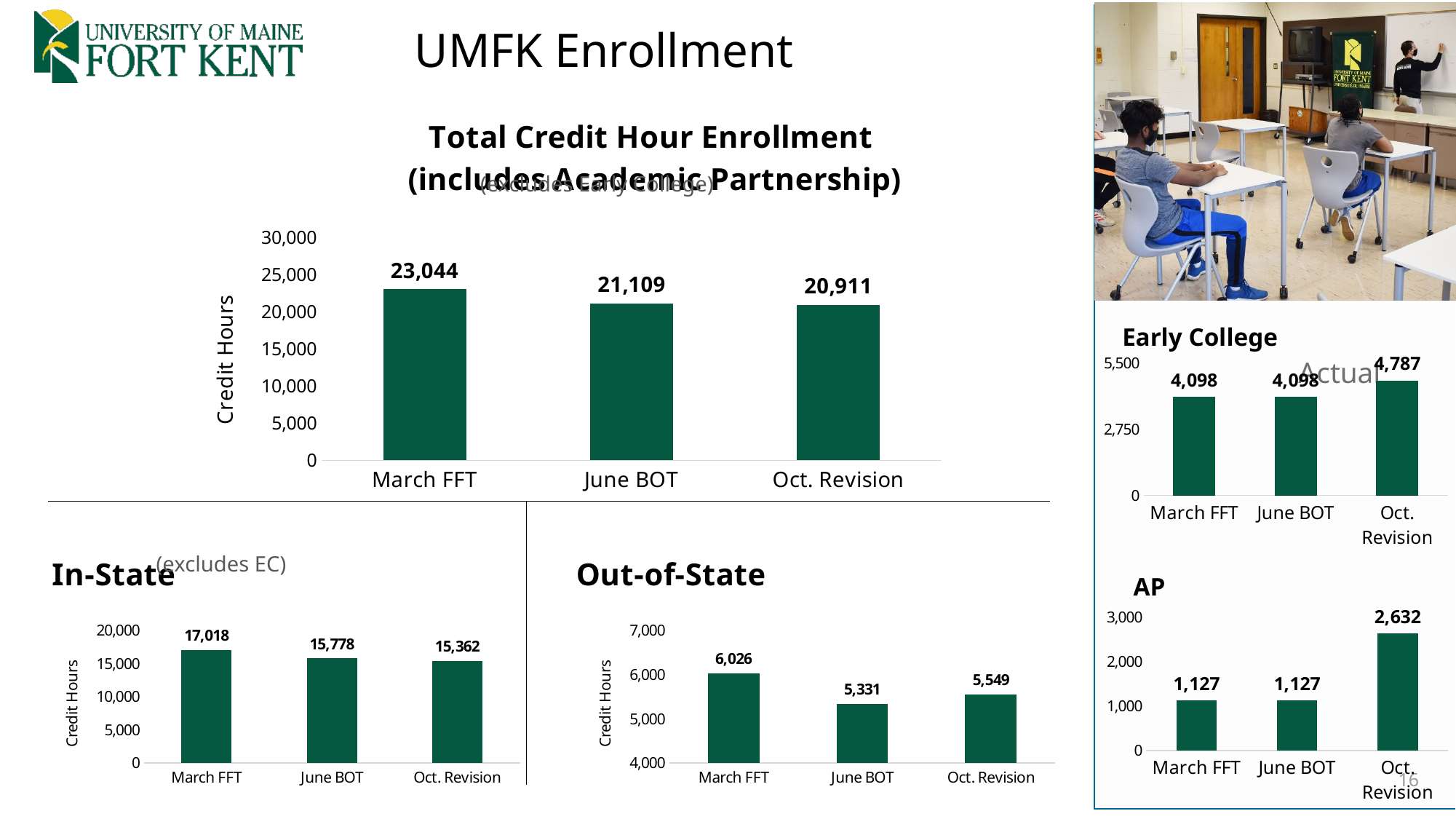
In the In-State chart, what is the value for June BOT? 15,778 In the Total Credit Hour Enrollment chart, what is the value for March FFT? 23,044 What kind of chart is the In-State chart? bar chart In the Out-of-State chart, which is larger, June BOT or Oct. Revision? Oct. Revision In the Out-of-State chart, which category has the highest value? March FFT In the Early College chart, what is the value for Oct. Revision? 4,787 In the AP chart, what is the value for Oct. Revision? 2,632 In the Total Credit Hour Enrollment chart, which category has the lowest value? Oct. Revision In the Total Credit Hour Enrollment chart, what is the difference between March FFT and June BOT? 1,935 In the In-State chart, do the values rise or fall from March FFT to Oct. Revision? fall In the Out-of-State chart, what is the difference between Oct. Revision and June BOT? 218 How many categories are shown in the AP chart? 3